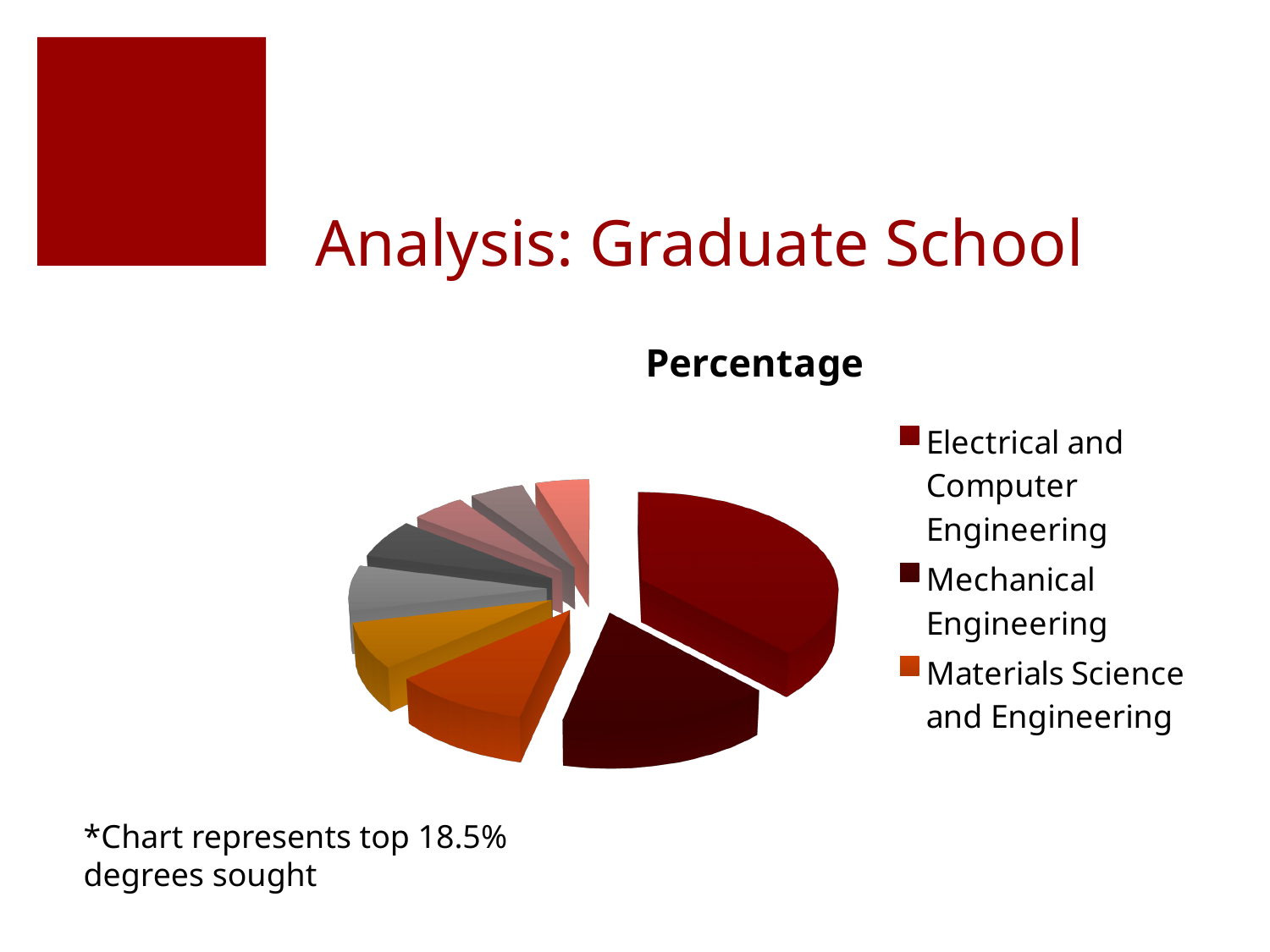
Which slice is larger: Electrical and Computer Engineering or Materials Science and Engineering? Electrical and Computer Engineering What kind of chart is shown on the slide? Pie chart Which slice is larger: Mechanical Engineering or Materials Science and Engineering? Mechanical Engineering What is the title of the chart? Percentage Which category has the largest slice of the pie? Electrical and Computer Engineering Which legend entry is shown in orange? Materials Science and Engineering How many entries does the chart's legend list? 3